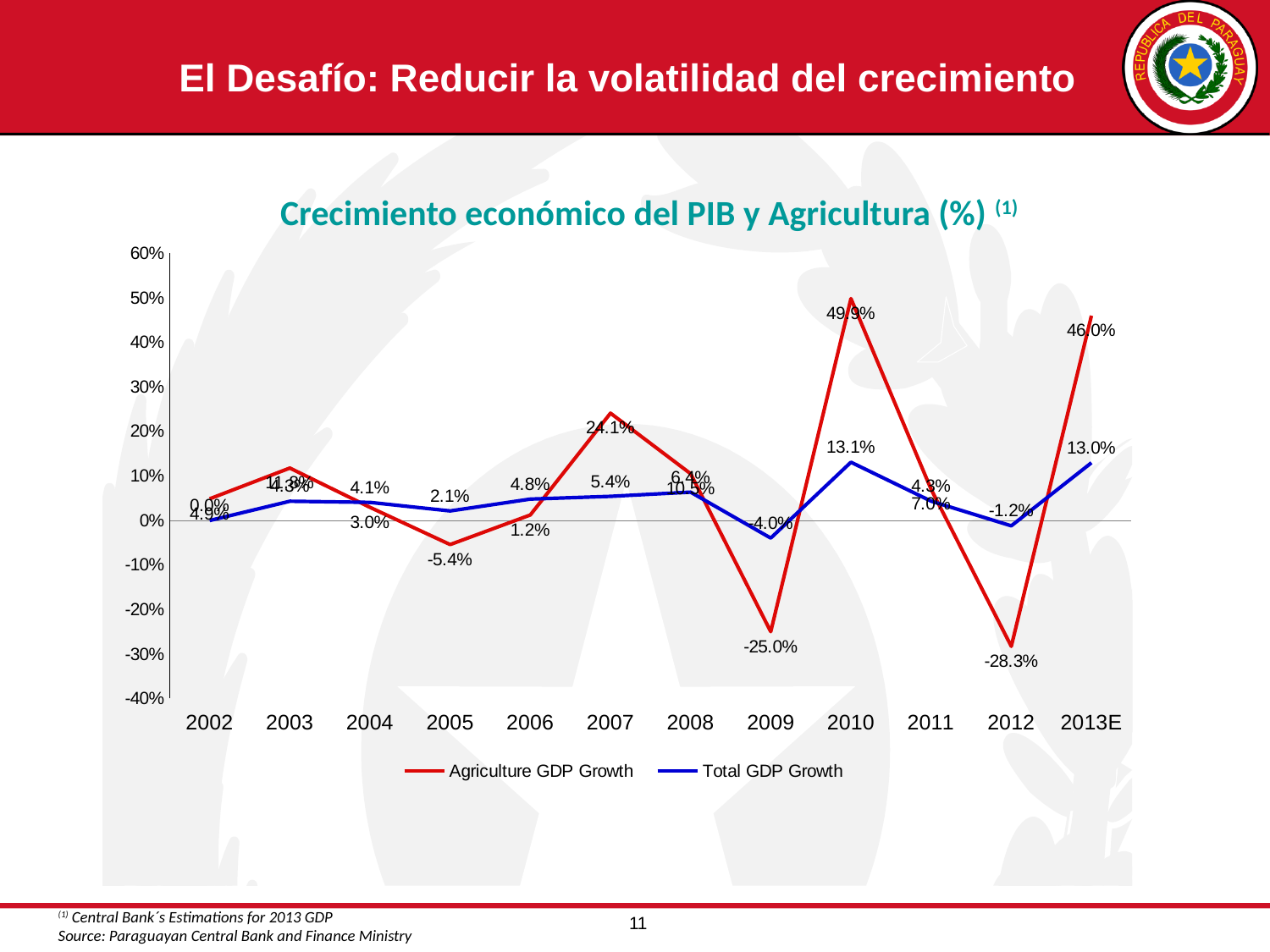
In which year is Agriculture GDP Growth lowest? 2012 What is the Total GDP Growth value for 2010? 13.1% How many series does the legend list? 2 What is the Agriculture GDP Growth value for 2012? -28.3% In which year is Agriculture GDP Growth highest? 2010 How many years are plotted along the x axis? 12 What is the Total GDP Growth value for 2013E? 13.0% What is the Agriculture GDP Growth value for 2010? 49.9% What is the Agriculture GDP Growth value for 2009? -25.0% What kind of chart is shown on the slide? Line chart In 2010, how much higher is Agriculture GDP Growth than Total GDP Growth? 36.8 percentage points Which series has the larger value in 2013E, Agriculture GDP Growth or Total GDP Growth? Agriculture GDP Growth